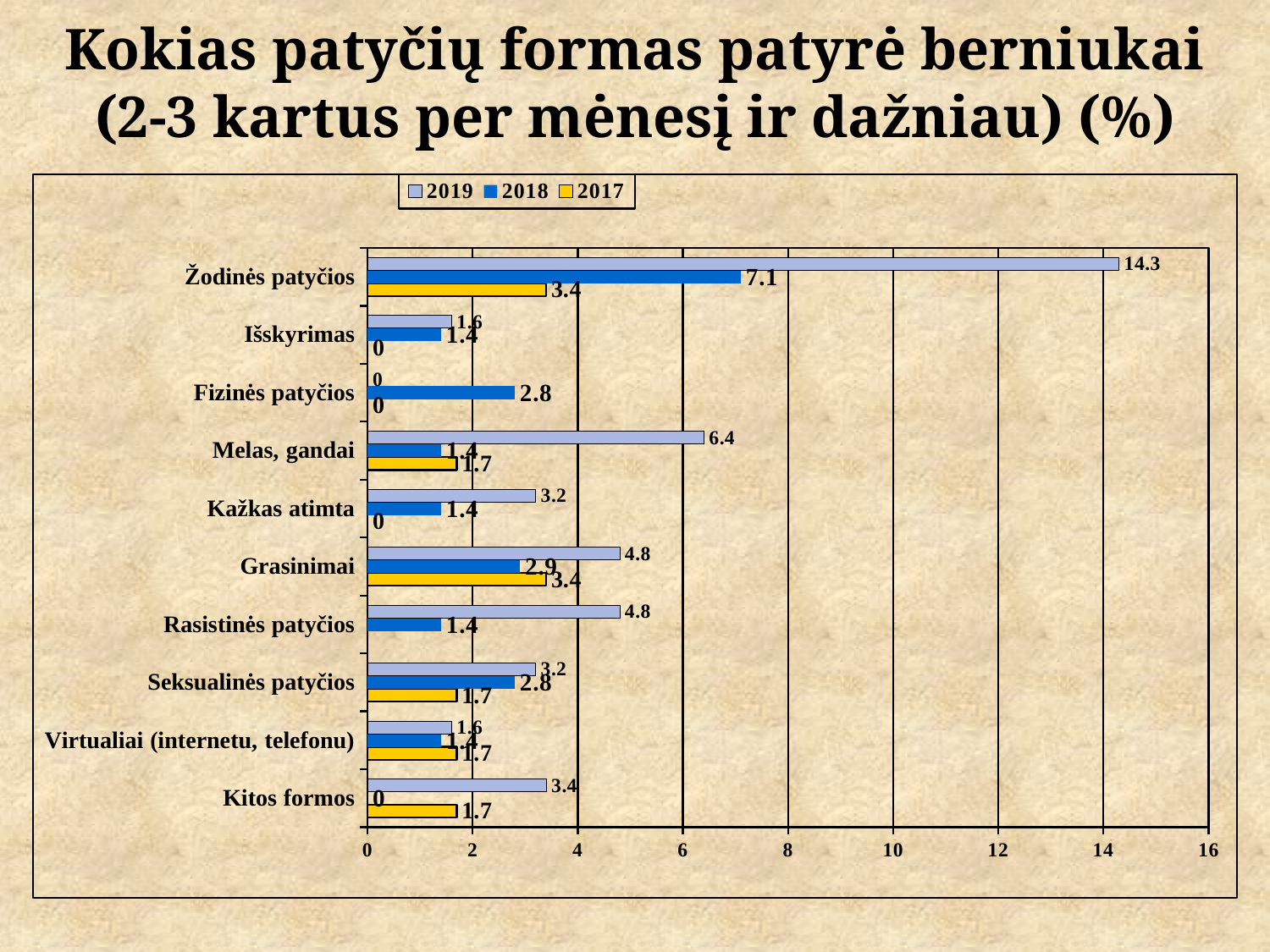
What is the 2017 value for Grasinimai? 3.4 What is the 2019 value for Melas, gandai? 6.4 Which is larger for Kitos formos, the 2019 value or the 2017 value? 2019 Which category has the highest 2019 value? Žodinės patyčios What is the 2018 value for Fizinės patyčios? 2.8 What is the difference between the 2019 and 2017 values for Melas, gandai? 4.7 What is the 2019 value for Žodinės patyčios? 14.3 What kind of chart is shown on the slide? Bar chart How many series does the legend list? 3 What is the difference between the 2019 and 2018 values for Žodinės patyčios? 7.2 Which category has the highest 2018 value? Žodinės patyčios How many categories are shown on the chart? 10